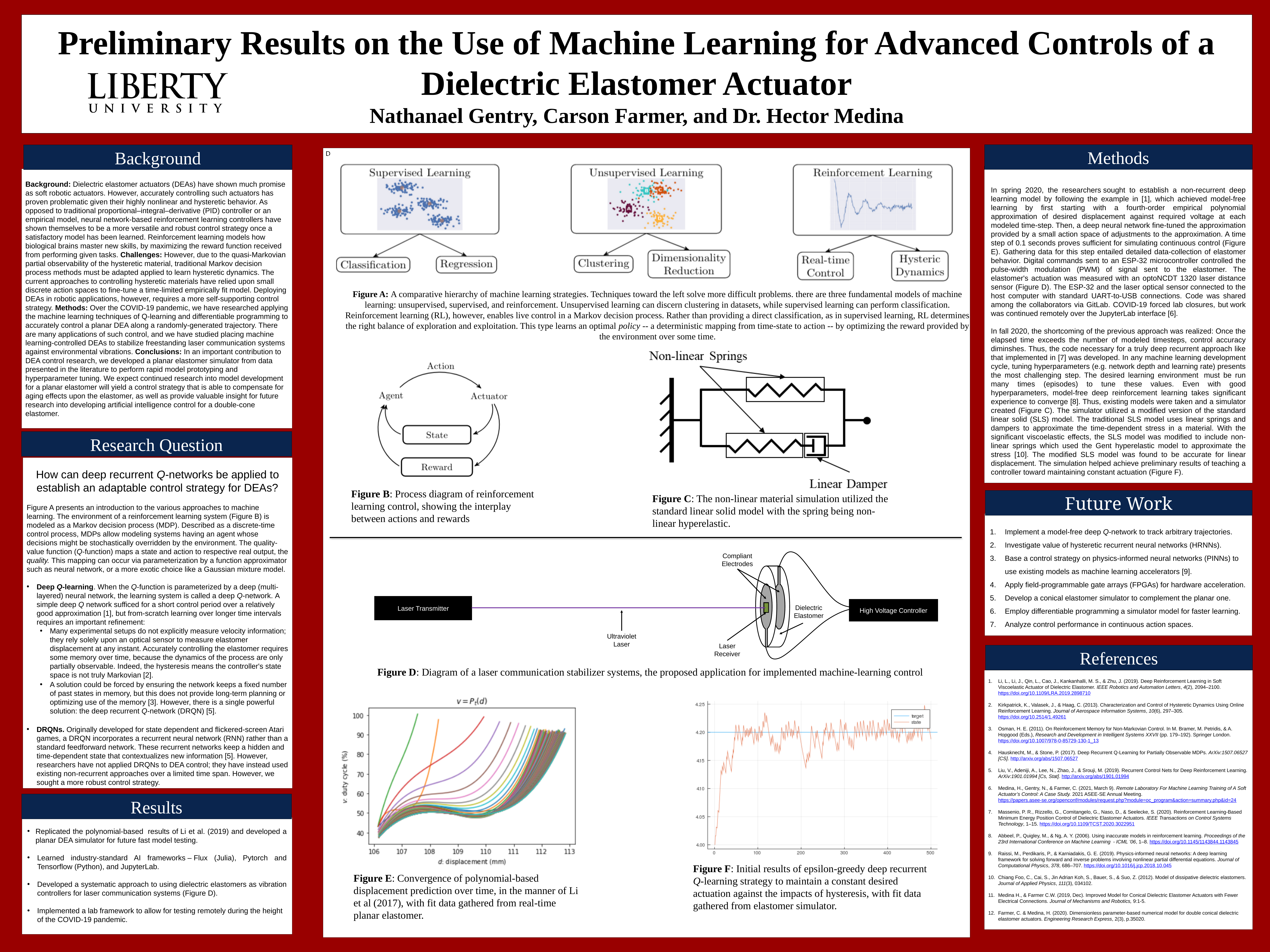
What are the two series named in the legend of Figure F? target and state In Figure E, do the duty cycle curves generally rise or fall as displacement increases from 106 to 113 mm? rise What is the title shown above the chart in Figure E? v = P_t(d) In Figure F, at what constant value does the target line sit? 4.20 In Figure E, is the duty cycle at a displacement of 106 mm greater or less than 50? less How many series does the legend in Figure F list? 2 In Figure F, is the state value at the very start (x = 0) greater or less than 4.10? less What kind of chart is Figure E? line chart In Figure E, is the highest duty cycle reached by any curve greater or less than 90? greater In Figure F, does the state series start below or above the target line? below In Figure F, does the state series rise or fall over the first 50 time steps? rise What kind of chart is Figure F? line chart